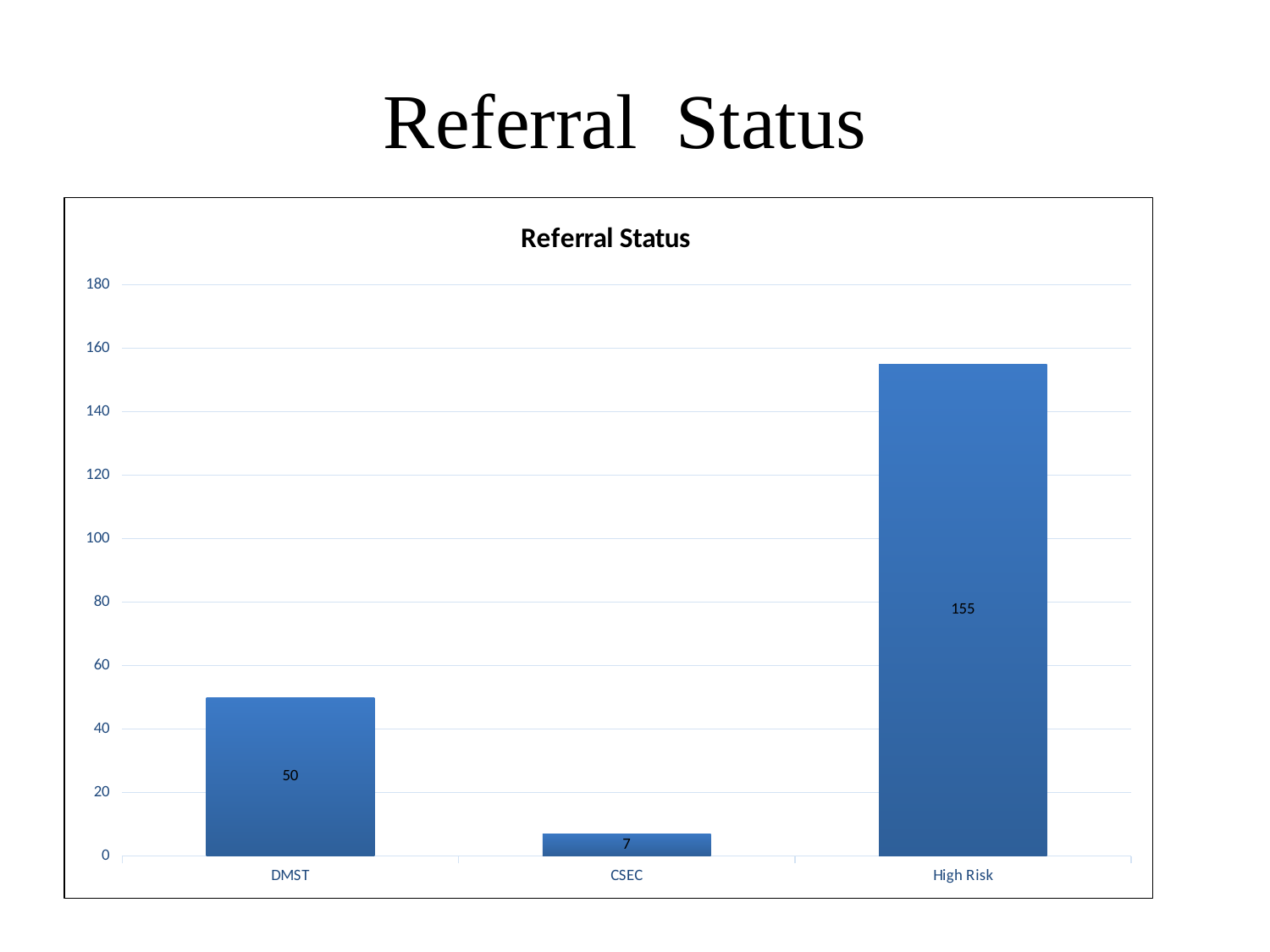
How many categories are shown on the x axis? 3 What is the difference between the values for DMST and CSEC? 43 Which category has the highest value? High Risk What is the value for DMST? 50 Is the value for High Risk greater or less than 140? greater What is the title of the chart? Referral Status What is the value for CSEC? 7 Which is larger, the value for DMST or the value for CSEC? DMST What kind of chart is shown on the slide? bar chart Which category has the lowest value? CSEC What is the difference between the values for High Risk and DMST? 105 What is the value for High Risk? 155